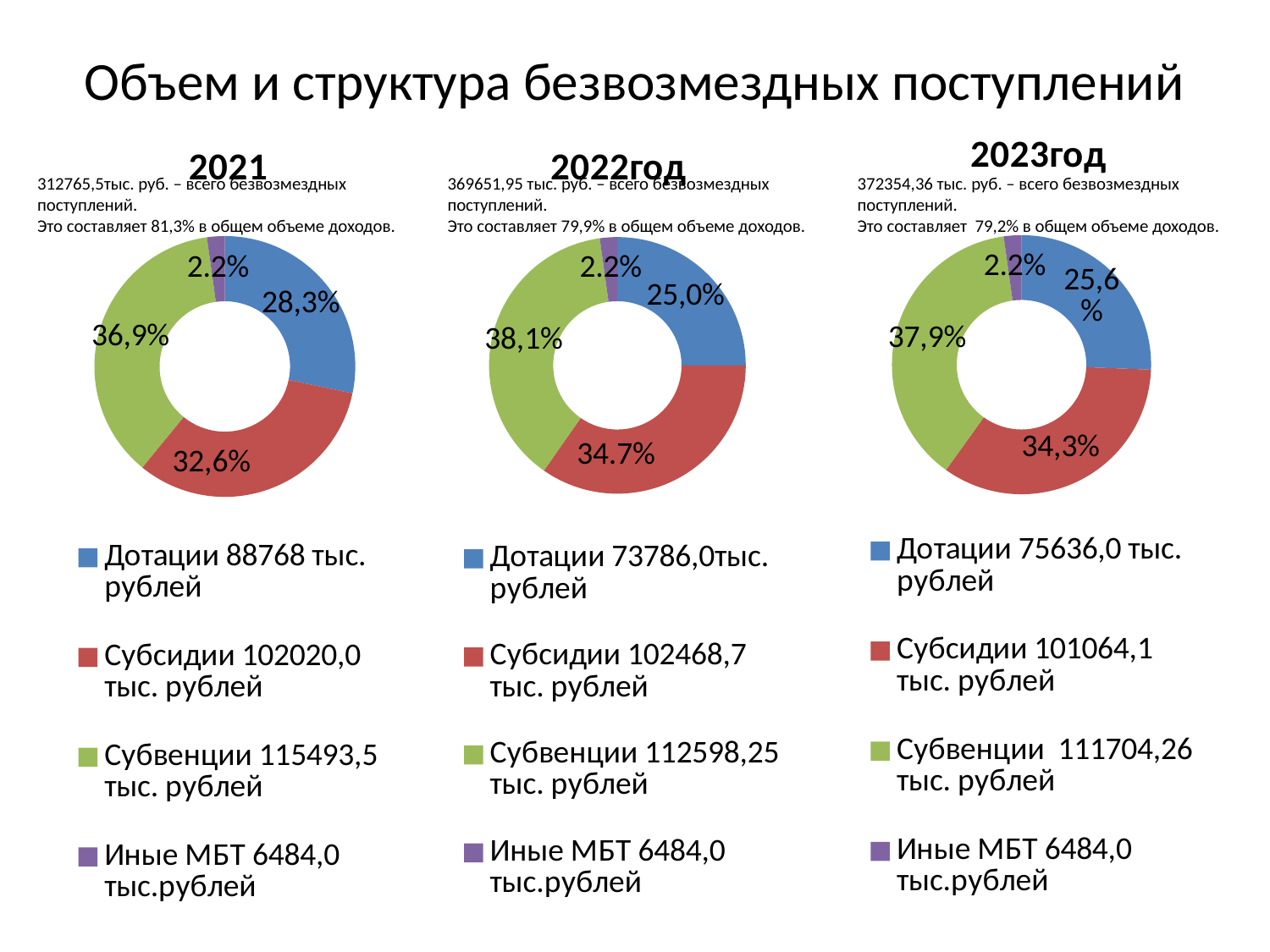
In the 2021 chart, what is the difference in percentage points between the Субвенции slice and the Дотации slice? 8,6 In the 2023год chart, what percentage is shown for Субсидии? 34,3% In the 2022год chart, what percentage is shown for Дотации? 25,0% What is the title of the slide? Объем и структура безвозмездных поступлений In the 2023год chart, what colour is the Субвенции slice? Green In the 2021 chart, which category has the largest slice? Субвенции What type of chart is used for the 2021 data? Donut (pie) chart How many slices does the 2022год chart have? 4 In the 2021 chart, what share of the donut is labelled for Субвенции? 36,9% In the 2023год chart, which category has the smallest slice? Иные МБТ In the 2022год chart, which slice is larger: Дотации or Субсидии? Субсидии How many entries does the legend of the 2023год chart list? 4